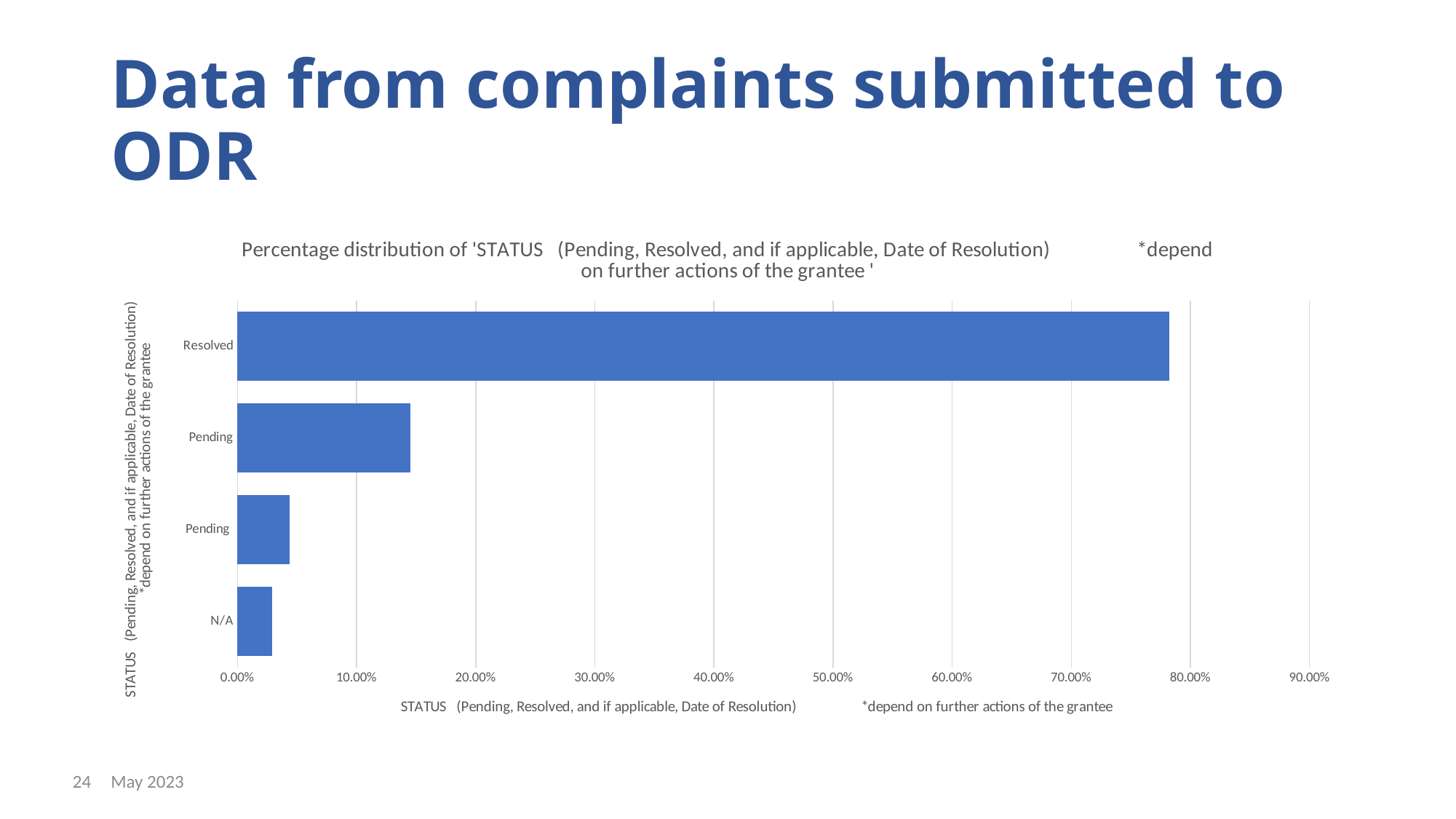
Is the value for Resolved greater or less than 80.00%? less Which category has the lowest percentage? N/A Which is larger, the value for Resolved or the value for N/A? Resolved What is the highest tick label shown on the horizontal axis? 90.00% Is the value for Resolved greater or less than 70.00%? greater What kind of chart is shown on the slide? bar chart Which category has the highest percentage? Resolved Is the value for the second bar from the top (Pending) greater or less than 10.00%? greater Which is larger, the second bar from the top (Pending) or the third bar from the top (Pending)? the second bar from the top How many bars (categories) does the chart show? 4